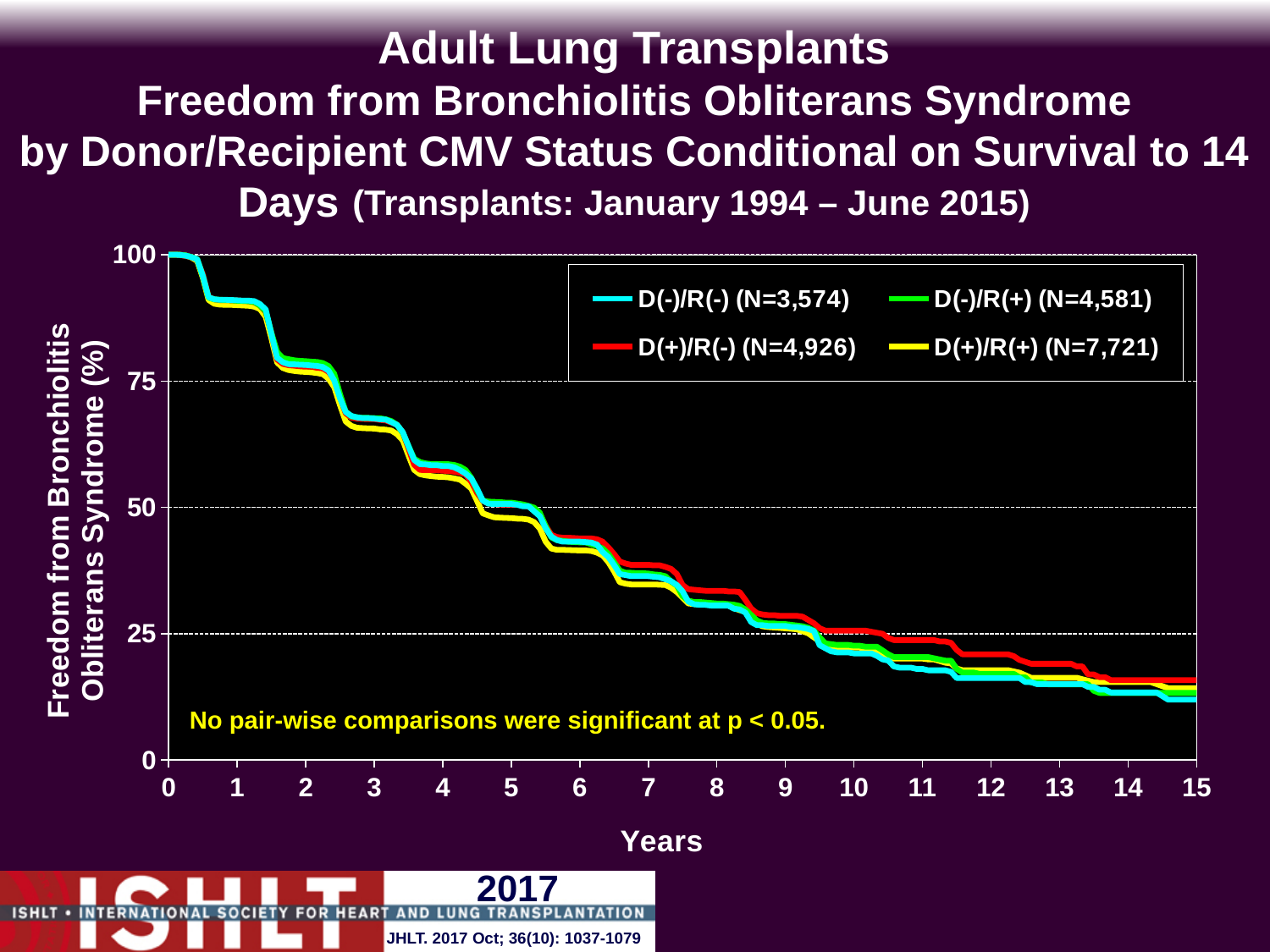
Do the values rise or fall as the years increase along the x axis? fall Is the value for D(-)/R(+) at year 7 greater or less than 50? less What is the label of the x axis? Years Is the value for D(-)/R(-) at year 1 greater or less than 75? greater What kind of chart is shown on the slide? line chart Is the value for D(+)/R(+) at year 3 greater or less than 50? greater Which series has the highest value at year 11? D(+)/R(-) How many series does the legend list? 4 What is the N shown in the legend for the D(+)/R(+) series? N=7,721